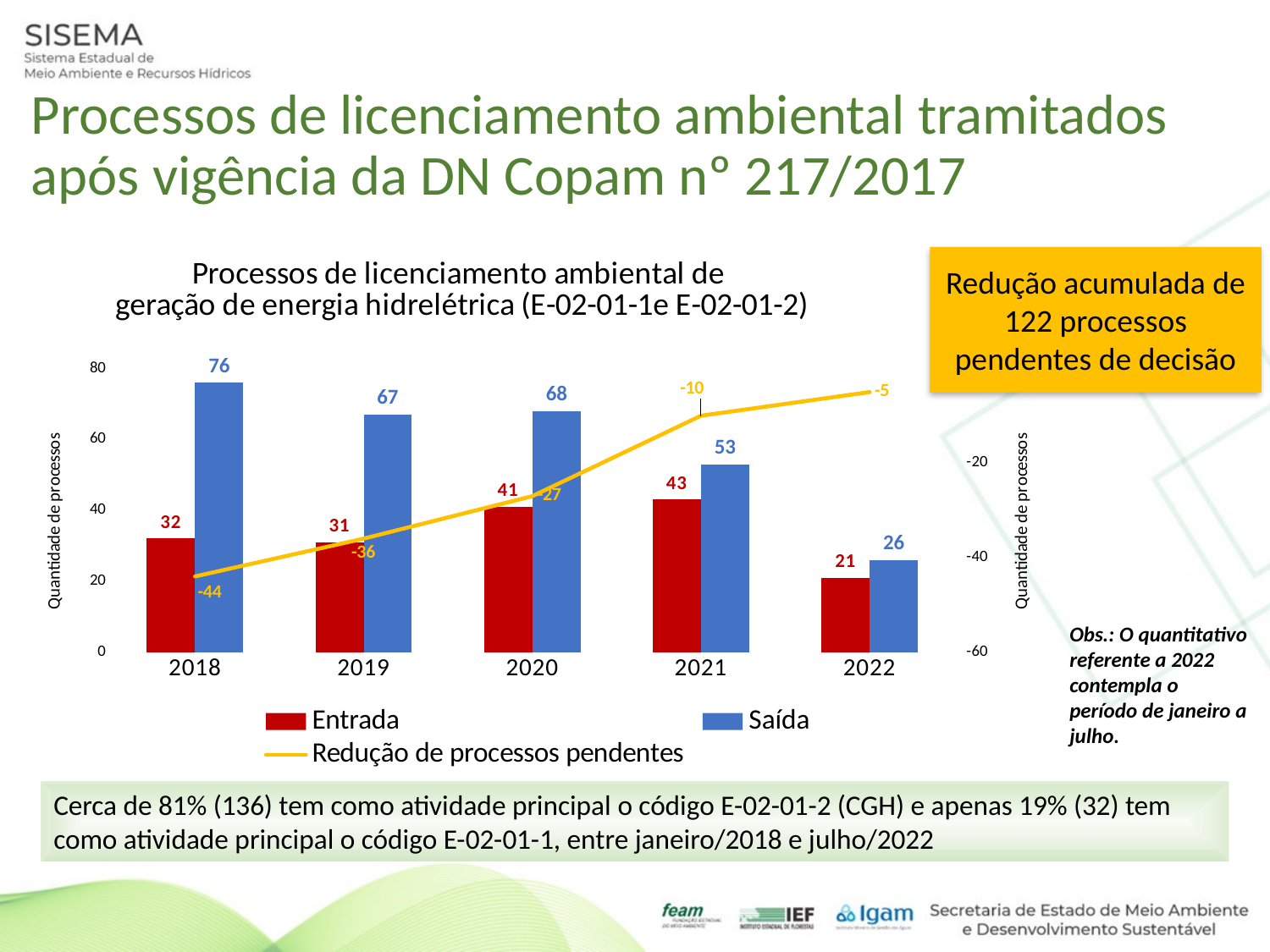
Which is larger in 2022, Entrada or Saída? Saída Which year has the lowest Entrada value? 2022 What is the difference between Saída and Entrada in 2020? 27 What kind of chart is used for the Entrada and Saída series? Bar chart How many series does the legend list? 3 What is the Entrada value for 2021? 43 How many years are shown on the x axis? 5 Is the Saída value for 2019 greater or less than 60? greater What is the Saída value for 2018? 76 What is the value of the Redução de processos pendentes line for 2019? -36 Does the Redução de processos pendentes line rise or fall from 2018 to 2022? Rises Which year has the highest Saída value? 2018